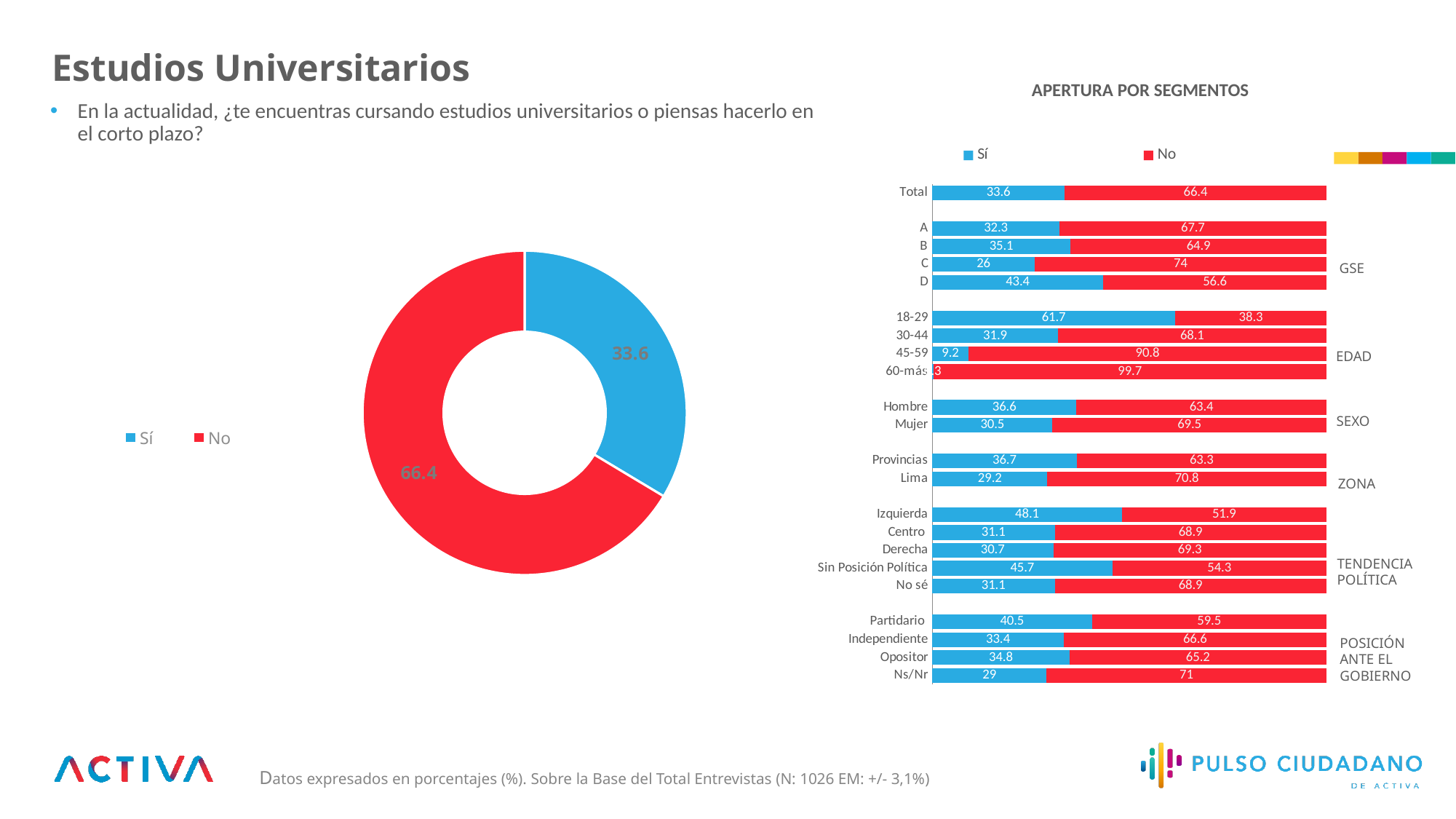
In the "APERTURA POR SEGMENTOS" chart, which segment has the highest "No" value? 60-más What kind of chart is the chart on the left of the slide? Donut (pie) chart What kind of chart is the "APERTURA POR SEGMENTOS" chart? Stacked bar chart In the "APERTURA POR SEGMENTOS" chart, what is the "No" value for Lima? 70.8 In the "APERTURA POR SEGMENTOS" chart, what is the "Sí" value for the 18-29 age group? 61.7 In the donut chart on the left, what is the value for "No"? 66.4 In the "APERTURA POR SEGMENTOS" chart, what is the difference between the "Sí" values for Hombre and Mujer? 6.1 In the "APERTURA POR SEGMENTOS" chart, which segment has the highest "Sí" value? 18-29 In the donut chart on the left, what is the value for "Sí"? 33.6 How many series does the legend of the "APERTURA POR SEGMENTOS" chart list? 2 In the donut chart on the left, which slice is larger, "Sí" or "No"? No In the "APERTURA POR SEGMENTOS" chart, which has a larger "Sí" value, Izquierda or Derecha? Izquierda